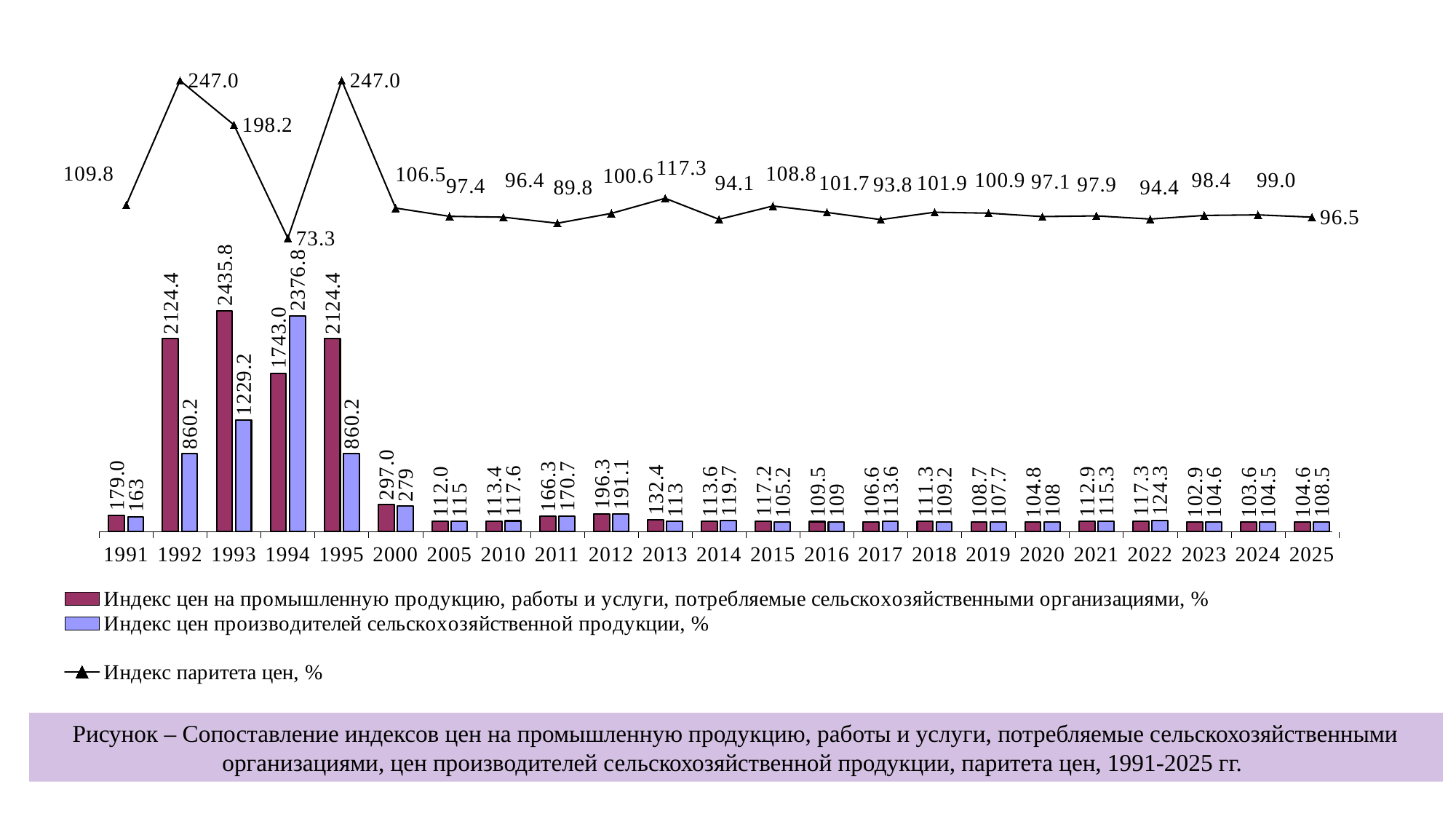
How many years are shown on the x axis? 23 In which year is the industrial products price index highest? 1993 In which year is the price parity index lowest? 1994 Which series is drawn as a line with triangle markers? Индекс паритета цен, % What is the agricultural producer price index (Индекс цен производителей сельскохозяйственной продукции) for 1994? 2376.8 What kind of chart is this? Combined bar and line chart What is the price parity index for 2013? 117.3 What is the value of the industrial products price index (Индекс цен на промышленную продукцию) for 1993? 2435.8 How many series does the legend list? 3 What is the price parity index (Индекс паритета цен) for 2025? 96.5 In 1994, which is larger: the industrial products price index or the agricultural producer price index? Agricultural producer price index What is the difference between the industrial products price index and the agricultural producer price index in 2013? 19.4